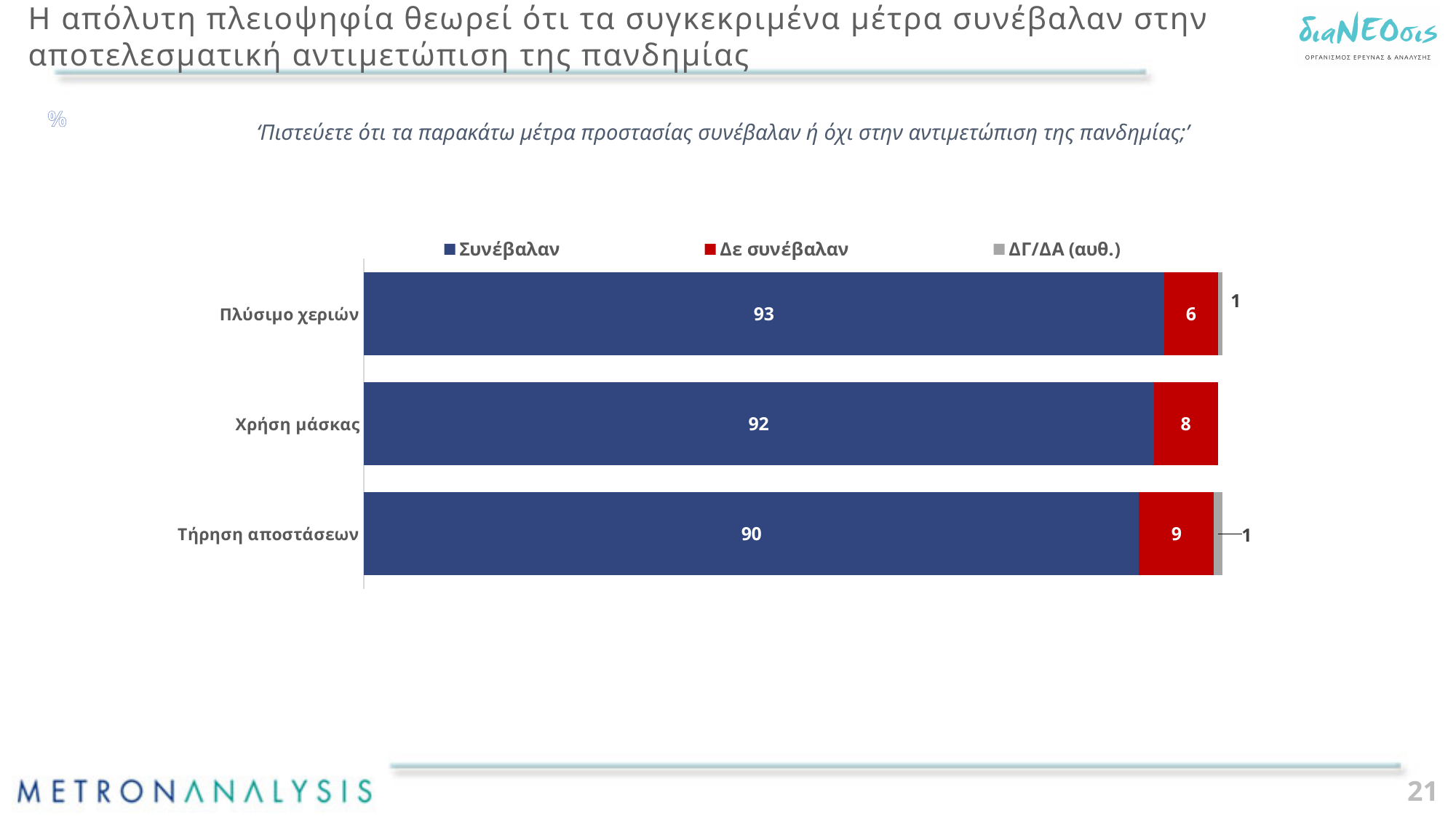
What is the value of ΔΓ/ΔΑ (αυθ.) for Τήρηση αποστάσεων? 1 Which measure has the highest Συνέβαλαν value? Πλύσιμο χεριών What percentage of respondents said that hand washing (Πλύσιμο χεριών) contributed (Συνέβαλαν) to tackling the pandemic? 93 What kind of chart is shown on the slide? Stacked bar chart How many measures (categories) are shown in the chart? 3 Which has a larger Δε συνέβαλαν value, Χρήση μάσκας or Τήρηση αποστάσεων? Τήρηση αποστάσεων Which measure has the lowest Συνέβαλαν value? Τήρηση αποστάσεων What is the difference between the Συνέβαλαν values for Πλύσιμο χεριών and Τήρηση αποστάσεων? 3 How many series does the legend list? 3 What is the value of Δε συνέβαλαν for Χρήση μάσκας? 8 What is the total of the stacked bar for Πλύσιμο χεριών? 100 Which colour represents the Δε συνέβαλαν series? Red